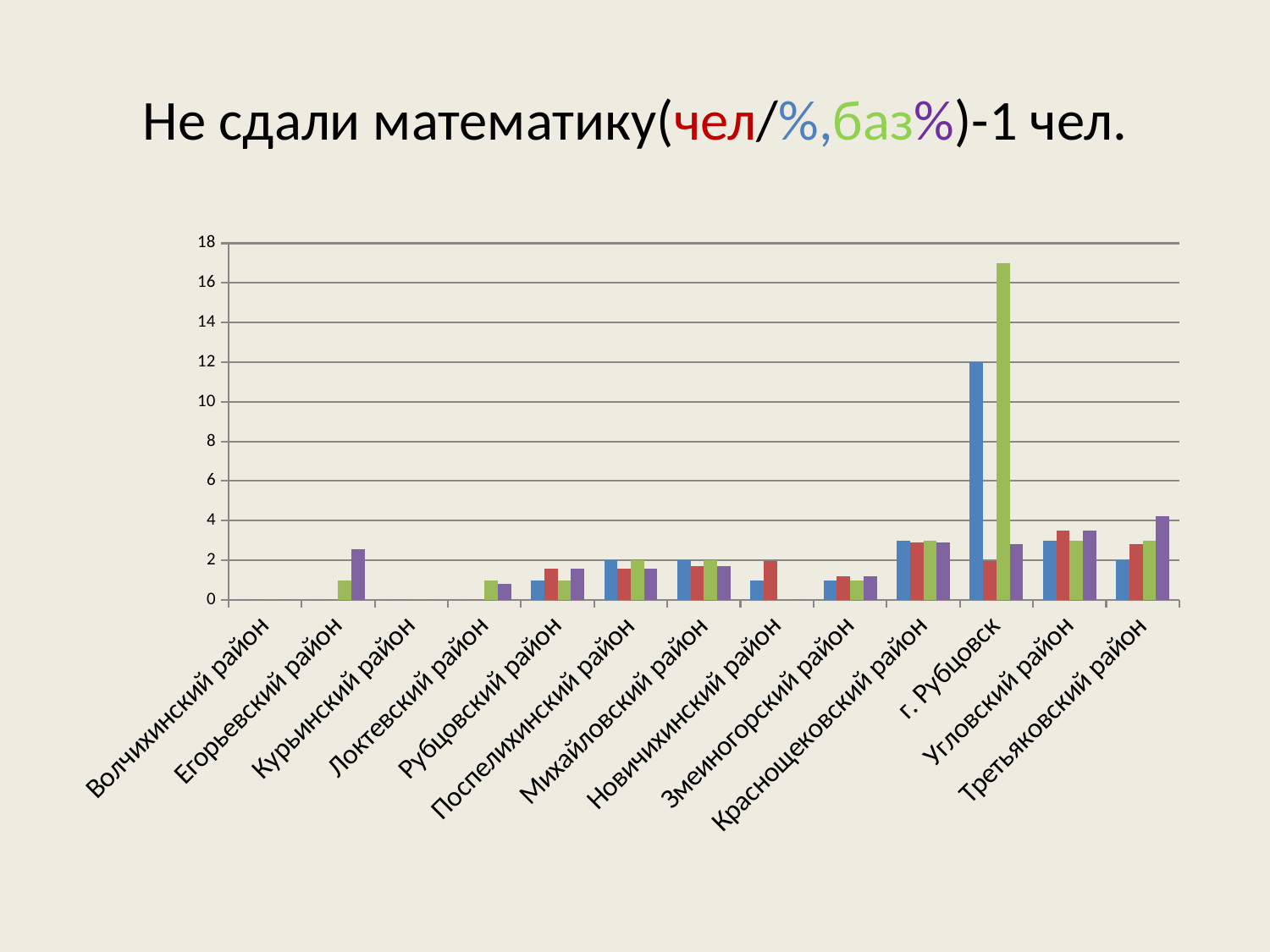
How many categories (districts) are shown on the x axis of the chart? 13 Which has the larger green bar: г. Рубцовск or Третьяковский район? г. Рубцовск What kind of chart is shown on the slide? bar chart Is the purple bar for Егорьевский район greater or less than 2? greater How many categories on the x axis show no bars at all? 2 Is the blue bar for г. Рубцовск greater or less than 10? greater Is the green bar for г. Рубцовск greater or less than 16? greater Which category has the tallest bar in the chart? г. Рубцовск How many different bar colours (series) are plotted in the chart? 4 What is the title of the chart on the slide? Не сдали математику(чел/%,баз%)-1 чел. Which has the larger blue bar: г. Рубцовск or Угловский район? г. Рубцовск